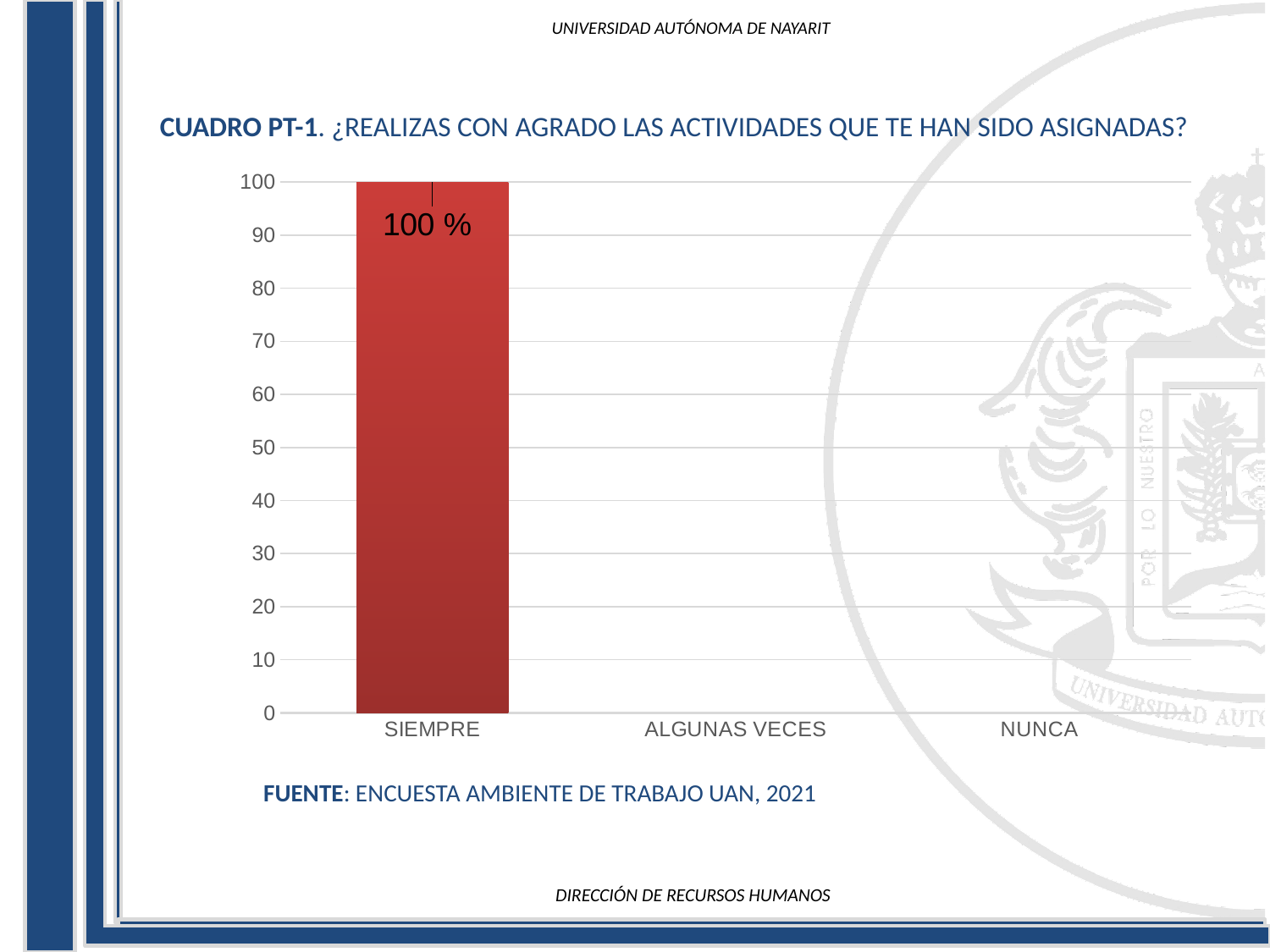
Which is larger, the value for SIEMPRE or the value for NUNCA? SIEMPRE What value is shown for SIEMPRE? 100 % Which is larger, the value for SIEMPRE or the value for ALGUNAS VECES? SIEMPRE Which category has the highest value? SIEMPRE Is the value for SIEMPRE greater or less than 50? greater What is the highest tick value on the vertical axis? 100 Is the value for SIEMPRE greater or less than 90? greater What is the source cited below the chart? ENCUESTA AMBIENTE DE TRABAJO UAN, 2021 What is the label of the third category on the x axis? NUNCA How many categories are shown on the x axis? 3 What kind of chart is shown on the slide? bar chart